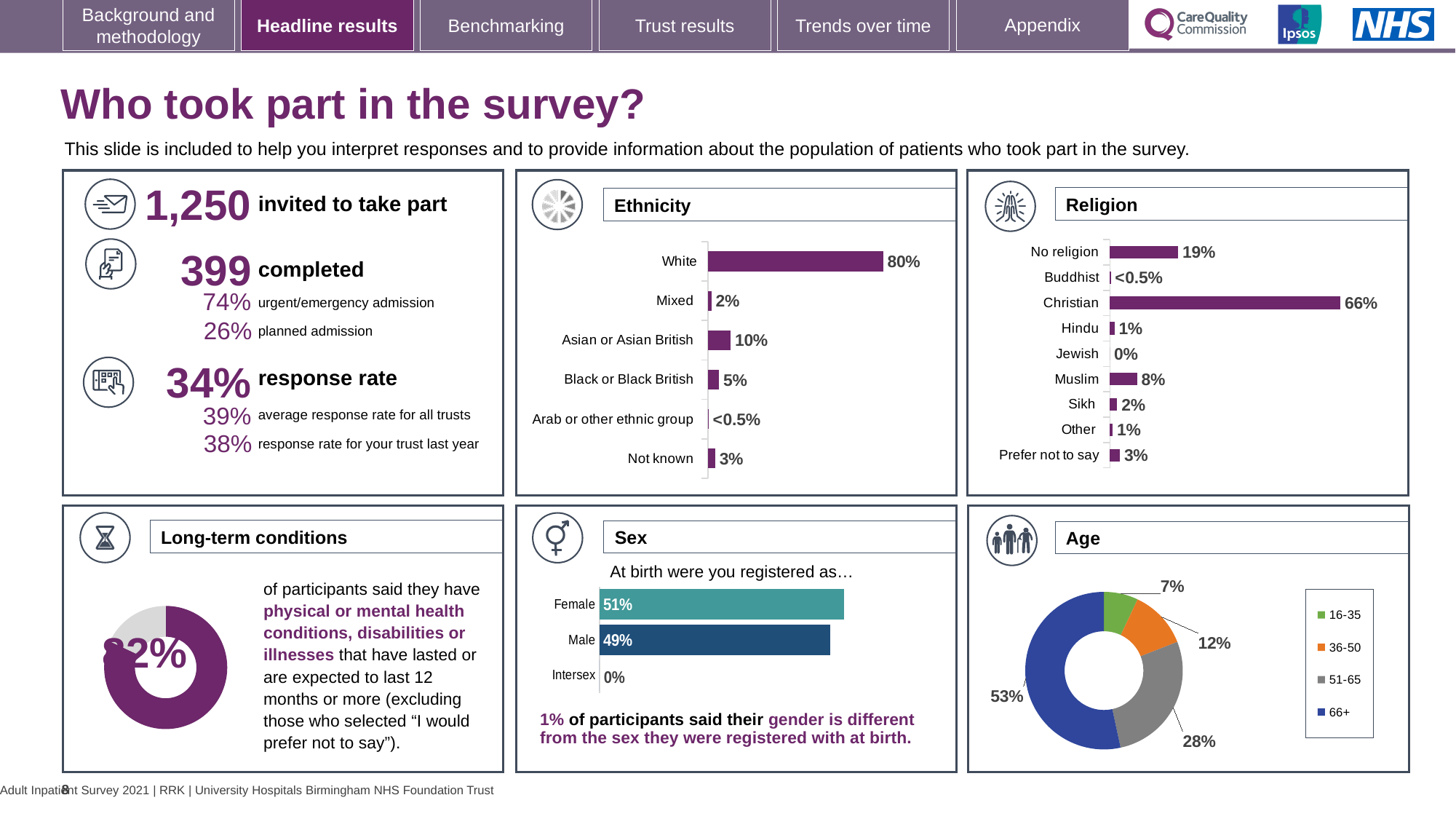
In the Ethnicity chart, what percentage of participants were White? 80% In the Ethnicity chart, what is the difference between the Asian or Asian British and Black or Black British percentages? 5% How many categories are shown in the Religion chart? 9 In the Religion chart, which category has the highest percentage? Christian How many age groups does the legend of the Age chart list? 4 In the Sex chart, what percentage of participants were registered as Female at birth? 51% In the Religion chart, which is larger: No religion or Muslim? No religion How many categories are shown in the Ethnicity chart? 6 What kind of chart is the Age chart? Doughnut chart In the Religion chart, what percentage of participants were Christian? 66% In the Age chart, what share of participants were aged 66+? 53% In the Ethnicity chart, which ethnic group has the lowest percentage? Arab or other ethnic group